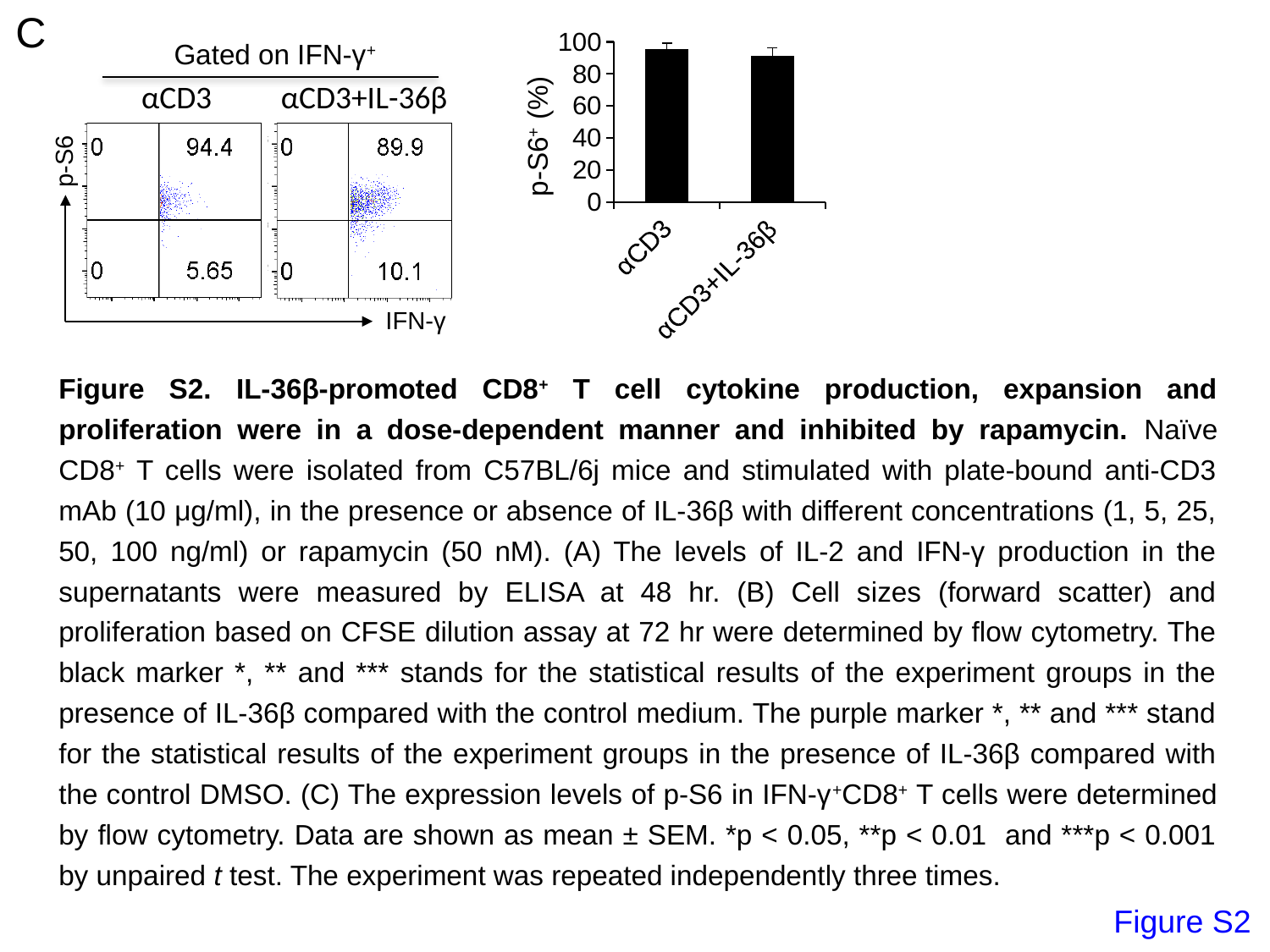
What population are the flow cytometry plots gated on, according to the heading above them? IFN-γ+ How many bars does the bar chart at the top right show? 2 In the bar chart, is the value for αCD3+IL-36β greater or less than 80? greater In the bar chart, is the value for αCD3+IL-36β greater or less than 100? less In the bar chart, is the value for αCD3 greater or less than 80? greater In the bar chart, which bar is taller, αCD3 or αCD3+IL-36β? αCD3 What is the y-axis label of the bar chart? p-S6+ (%) What kind of chart is shown at the top right of the slide? bar chart In the αCD3+IL-36β flow cytometry plot, what percentage is printed in the upper right quadrant? 89.9 In the αCD3+IL-36β flow cytometry plot, what percentage is printed in the lower right quadrant? 10.1 In the αCD3 flow cytometry plot, what percentage is printed in the upper right quadrant? 94.4 What is the difference between the upper right quadrant values of the αCD3 plot (94.4) and the αCD3+IL-36β plot (89.9)? 4.5